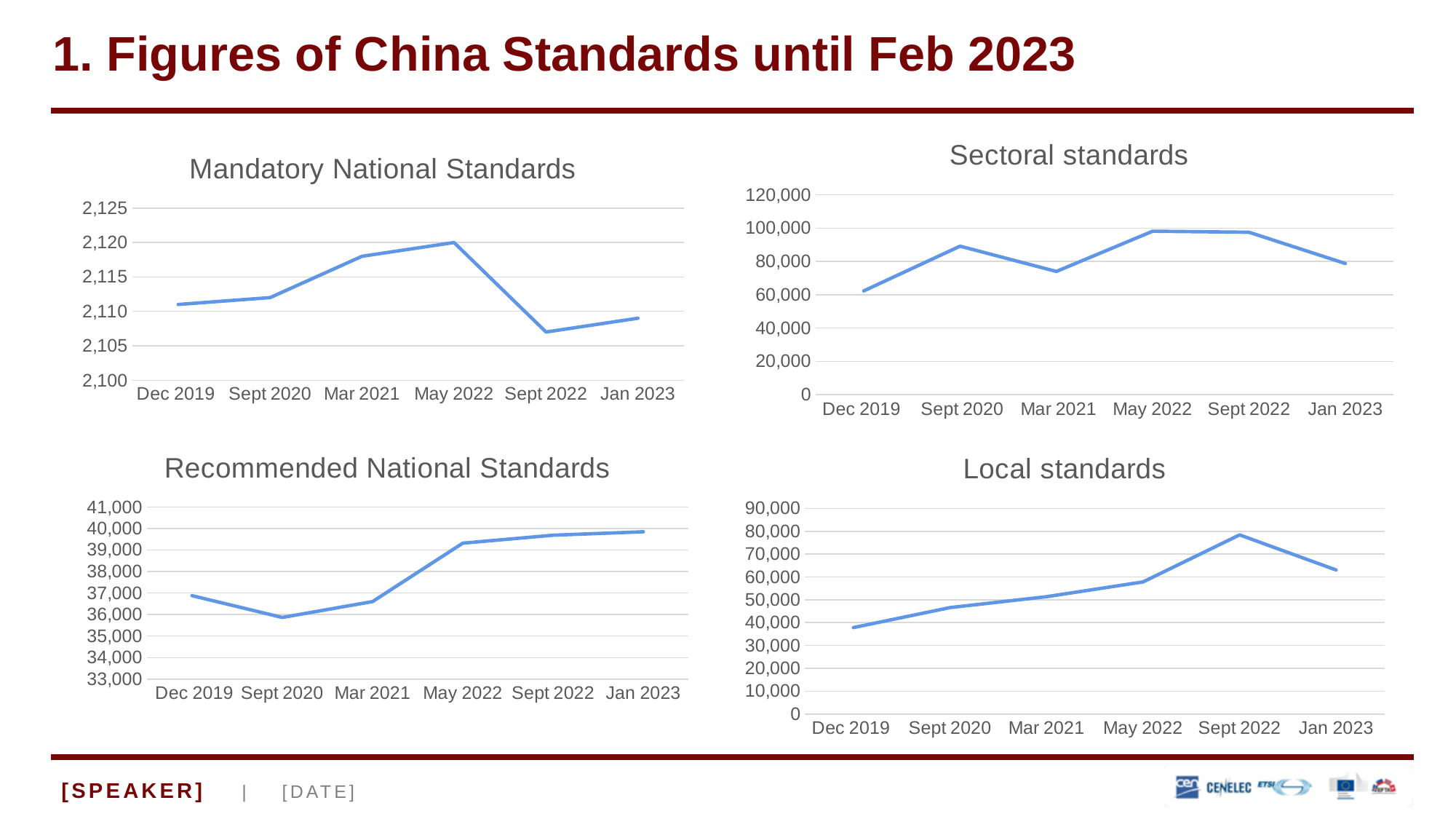
In the Mandatory National Standards chart, which time point has the highest value? May 2022 In the Local standards chart, is the value for Jan 2023 greater or less than 60,000? greater In the Local standards chart, which time point has the highest value? Sept 2022 How many time points are plotted on the Sectoral standards chart? 6 In the Sectoral standards chart, which time point has the lowest value? Dec 2019 In the Local standards chart, which time point has the lowest value? Dec 2019 What kind of chart is the Mandatory National Standards chart? line chart In the Local standards chart, which is larger: the value for Sept 2022 or the value for May 2022? Sept 2022 In the Mandatory National Standards chart, which time point has the lowest value? Sept 2022 In the Recommended National Standards chart, is the value for May 2022 greater or less than 39,000? greater In the Sectoral standards chart, is the value for Jan 2023 greater or less than 100,000? less